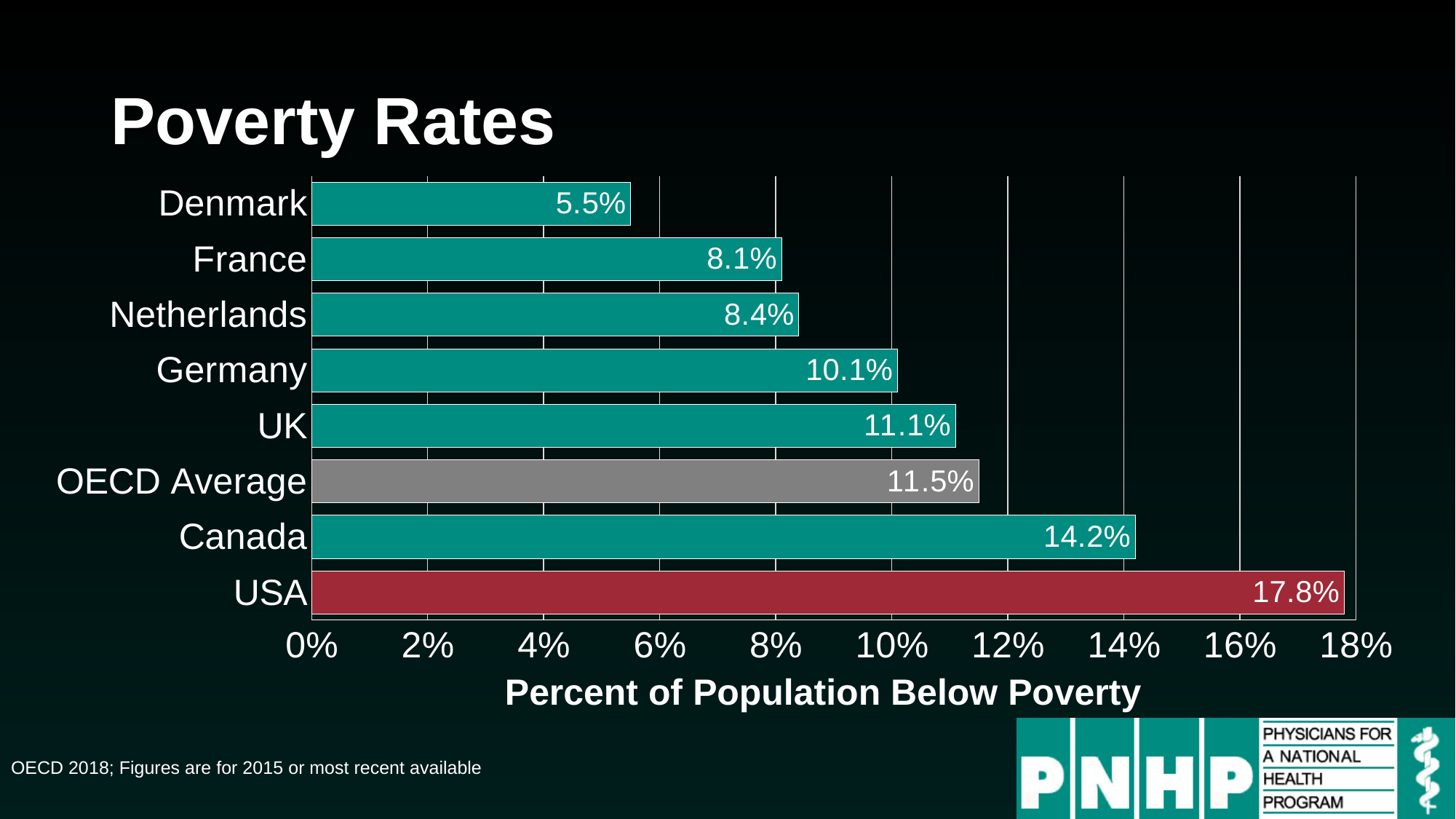
How many bars are shown on the chart? 8 Which country has the lowest poverty rate on the chart? Denmark What is the difference between the USA's poverty rate and the OECD Average? 6.3% What is the poverty rate shown for Denmark? 5.5% Which country has the highest poverty rate on the chart? USA What is the label of the horizontal axis? Percent of Population Below Poverty What is the poverty rate shown for the USA? 17.8% Which has a higher poverty rate, the UK or the Netherlands? UK What is the difference between Germany's and France's poverty rates? 2.0% What is the value shown for the OECD Average? 11.5% What type of chart is shown on the slide? Bar chart What is the poverty rate shown for Canada? 14.2%